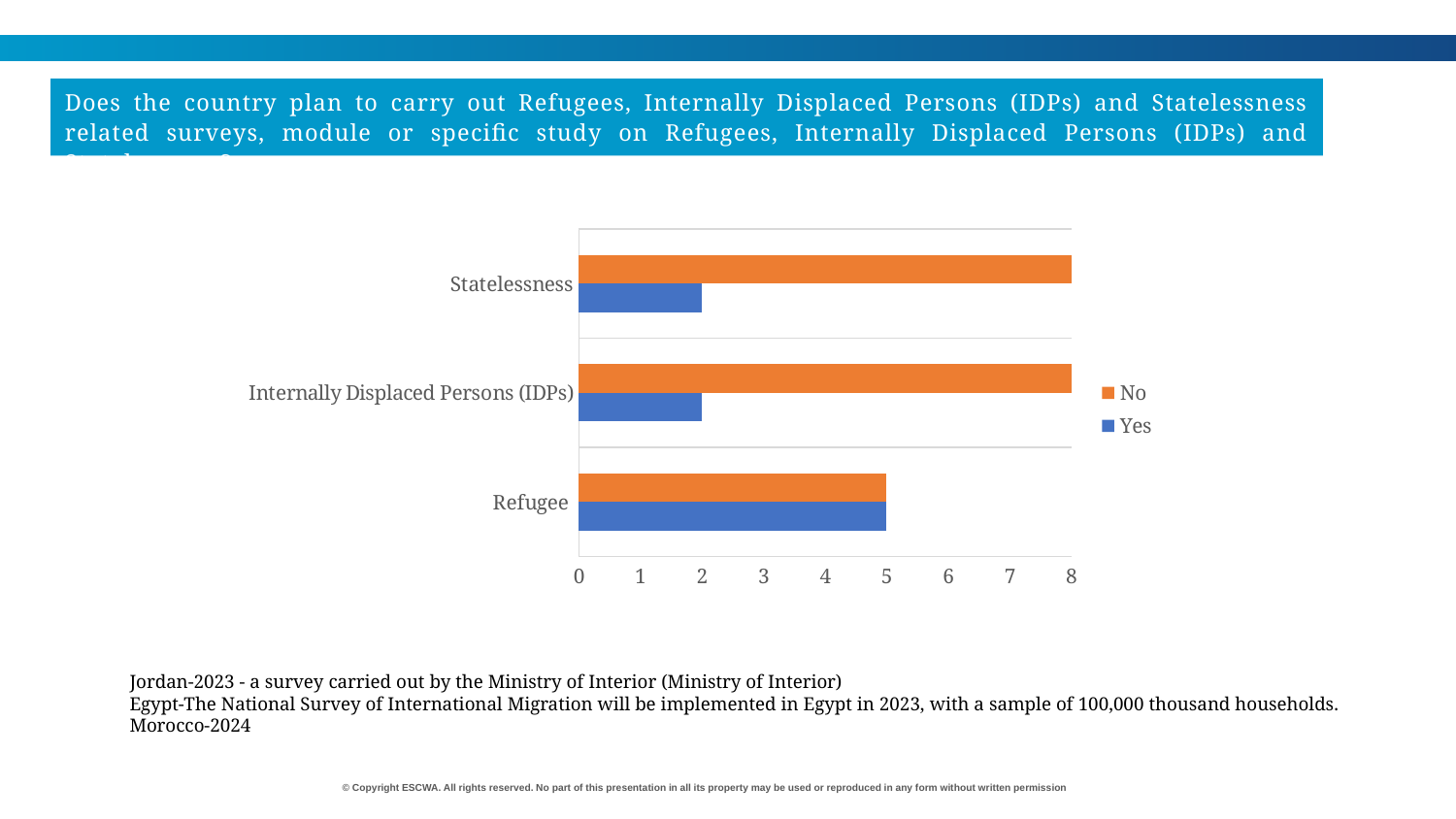
What is the value of the Yes series for Refugee? 5 Which colour represents the Yes series in the legend? blue How many categories are shown on the chart? 3 Which category has the lowest value for the No series? Refugee What is the value of the No series for Internally Displaced Persons (IDPs)? 8 What is the difference between the No and Yes values for Statelessness? 6 What kind of chart is shown on the slide? bar chart How many series does the legend list? 2 Which category has the highest value for the Yes series? Refugee What is the value of the No series for Statelessness? 8 What is the value of the Yes series for Statelessness? 2 For Internally Displaced Persons (IDPs), which is larger, the No value or the Yes value? No